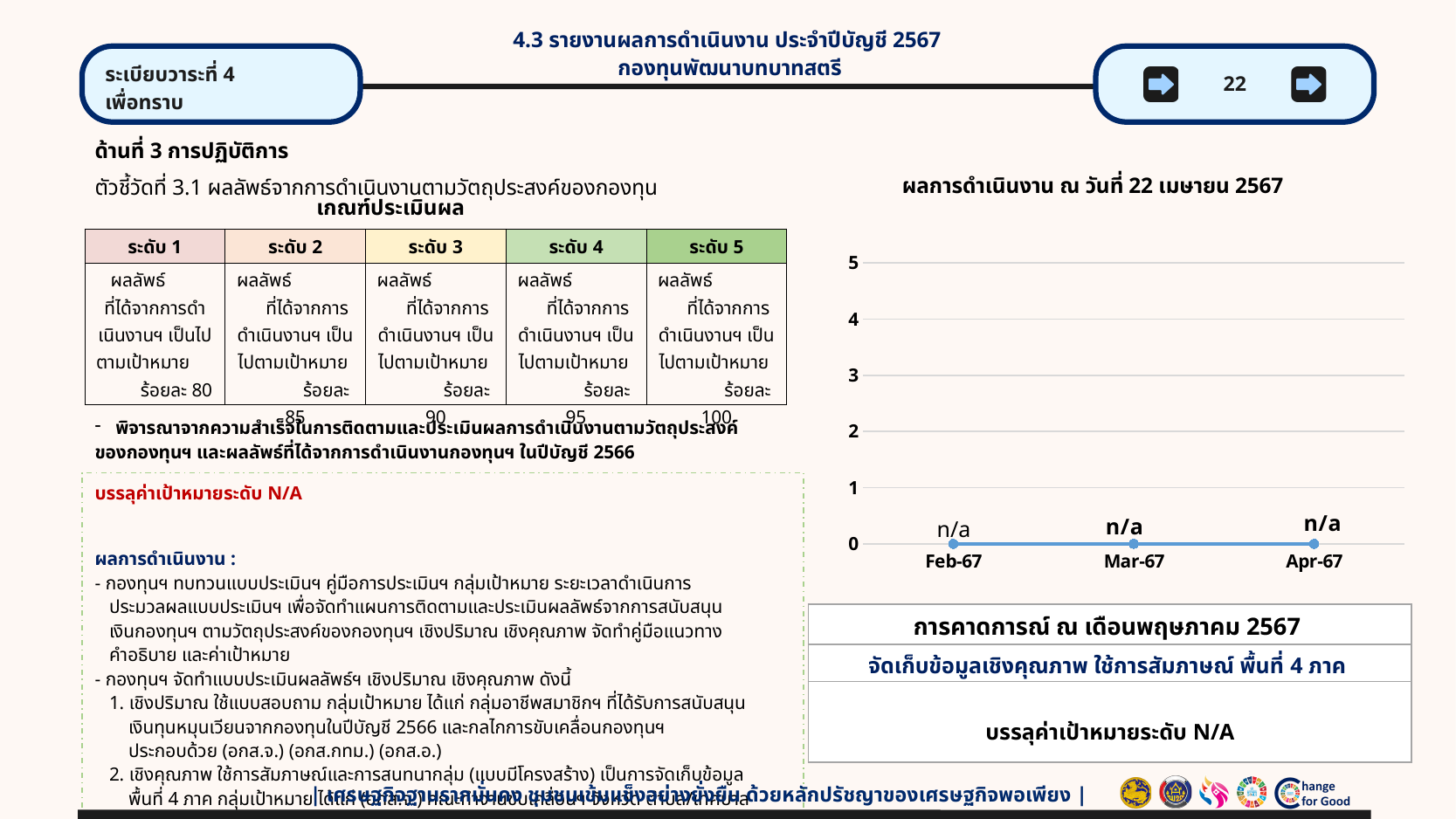
What is the label of the first category on the x axis of the line chart? Feb-67 Is the plotted point for Mar-67 on the line chart greater or less than 1? less What kind of chart is shown on the right side of the slide? line chart What is the data label shown for Feb-67 on the line chart? n/a What is the title of the line chart? ผลการดำเนินงาน ณ วันที่ 22 เมษายน 2567 Do the plotted values on the line chart rise, fall, or stay flat from Feb-67 to Apr-67? stay flat How many data points are plotted on the line chart? 3 What is the label of the last category on the x axis of the line chart? Apr-67 What is the data label shown for Mar-67 on the line chart? n/a What is the data label shown for Apr-67 on the line chart? n/a What is the highest value shown on the y axis of the line chart? 5